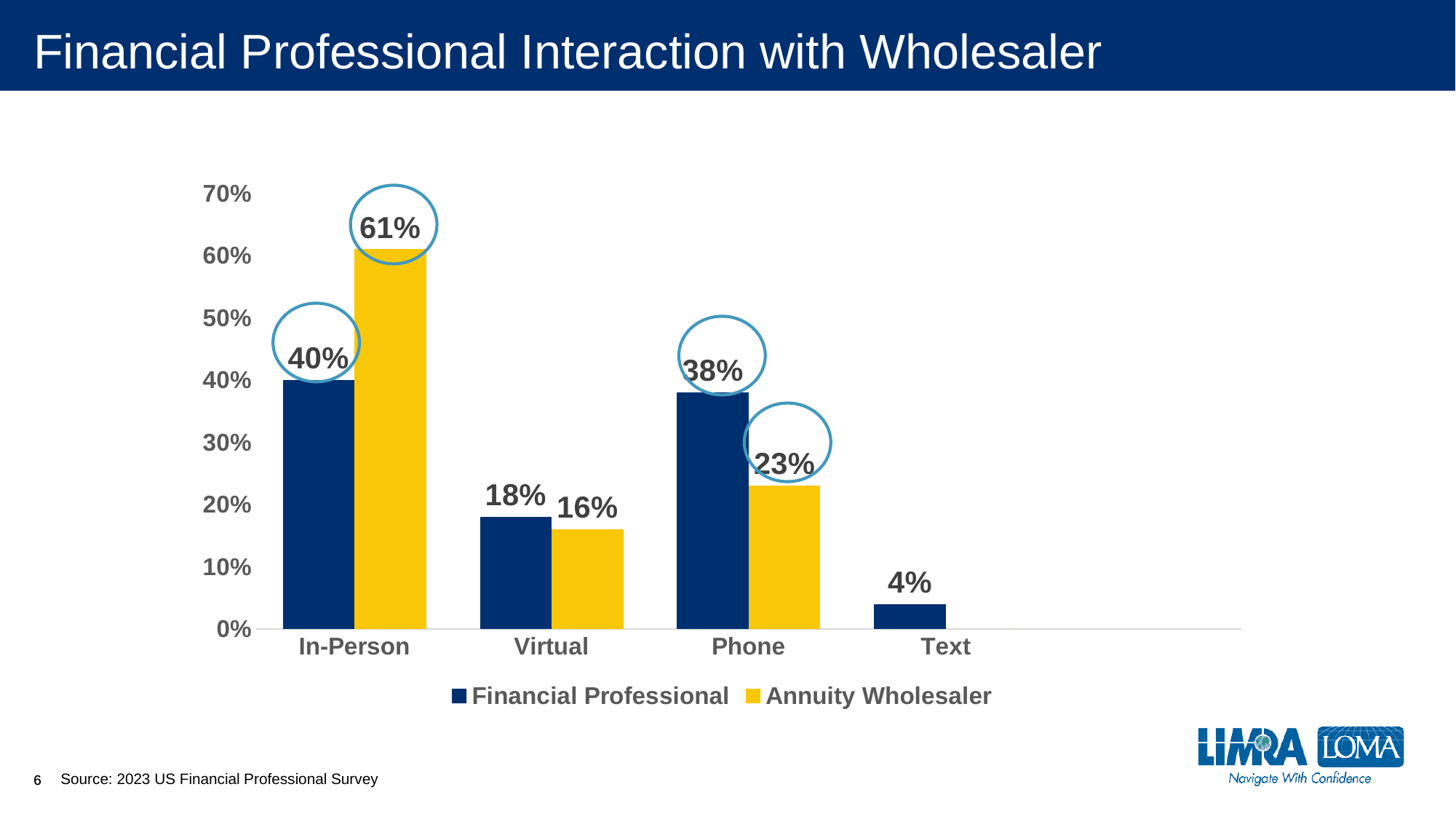
Is the Annuity Wholesaler value for In-Person greater or less than 50%? greater What is the difference between the Financial Professional and Annuity Wholesaler values for Phone? 15% Which category has the lowest value for the Annuity Wholesaler series among those with a plotted bar? Virtual What is the difference between the Annuity Wholesaler and Financial Professional values for In-Person? 21% How many categories are shown on the x axis? 4 What is the value for Financial Professional in the Phone category? 38% What kind of chart is shown on the slide? Bar chart How many series does the legend list? 2 What is the value for Annuity Wholesaler in the In-Person category? 61% What is the value for Financial Professional in the Text category? 4% Which category has the highest value for the Financial Professional series? In-Person Which is larger for Virtual: Financial Professional or Annuity Wholesaler? Financial Professional